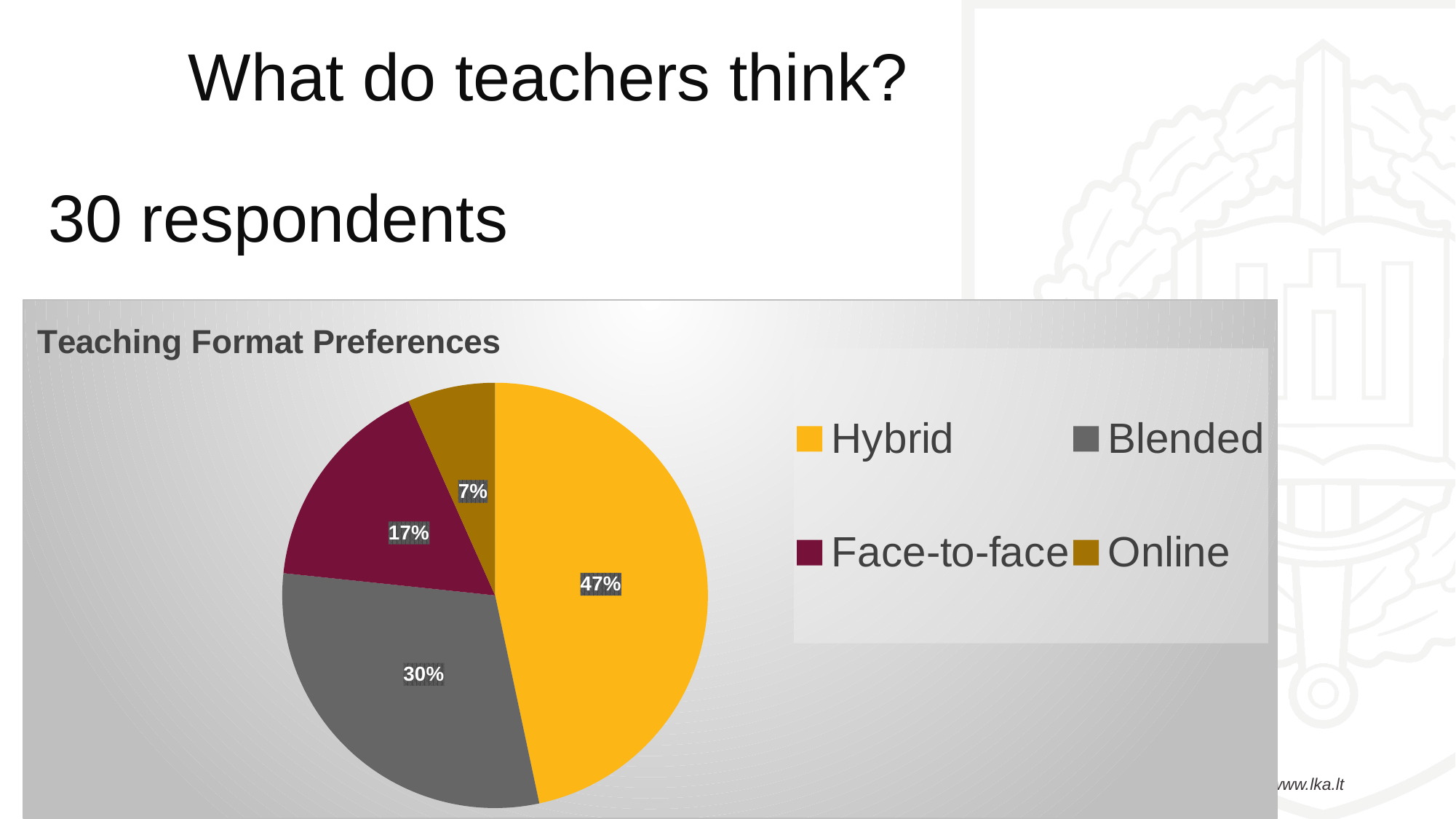
Which colour represents Face-to-face in the legend? dark red What share of the pie does Online represent? 7% What share of the pie does Hybrid represent? 47% How many categories does the pie chart show? 4 What is the difference in percentage points between the Hybrid and Blended shares? 17 Which teaching format has the smallest share of the pie? Online What share of the pie does Blended represent? 30% What share of the pie does Face-to-face represent? 17% What is the title of the chart? Teaching Format Preferences What type of chart is shown on the slide? pie chart Which teaching format has the largest share of the pie? Hybrid Which has a larger share, Face-to-face or Online? Face-to-face